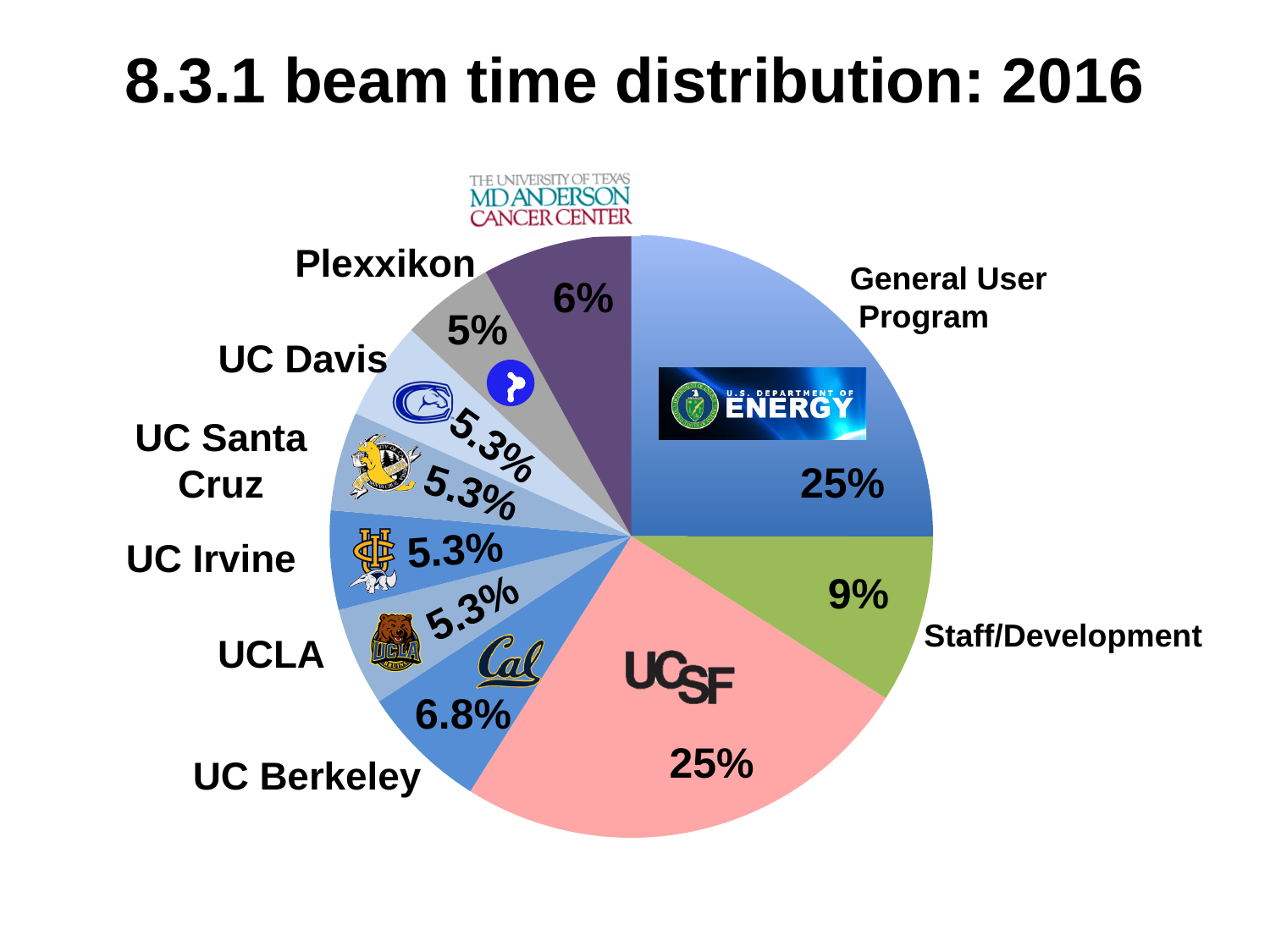
What percentage is shown for Staff/Development? 9% How many percentage points larger is the UC Berkeley slice than the UCLA slice? 1.5% What percentage is shown for the UCSF slice? 25% How many slices does the pie chart have? 10 Which labelled slice has the smallest share of beam time? Plexxikon What is the difference in percentage points between the General User Program slice and the Staff/Development slice? 16% Which is larger, the Staff/Development slice or the UC Berkeley slice? Staff/Development What type of chart is shown on the slide? Pie chart What percentage is shown for the Plexxikon slice? 5% What percentage is shown for UCLA? 5.3% What percentage of beam time is labelled for UC Berkeley? 6.8% What share of beam time does the General User Program slice show? 25%